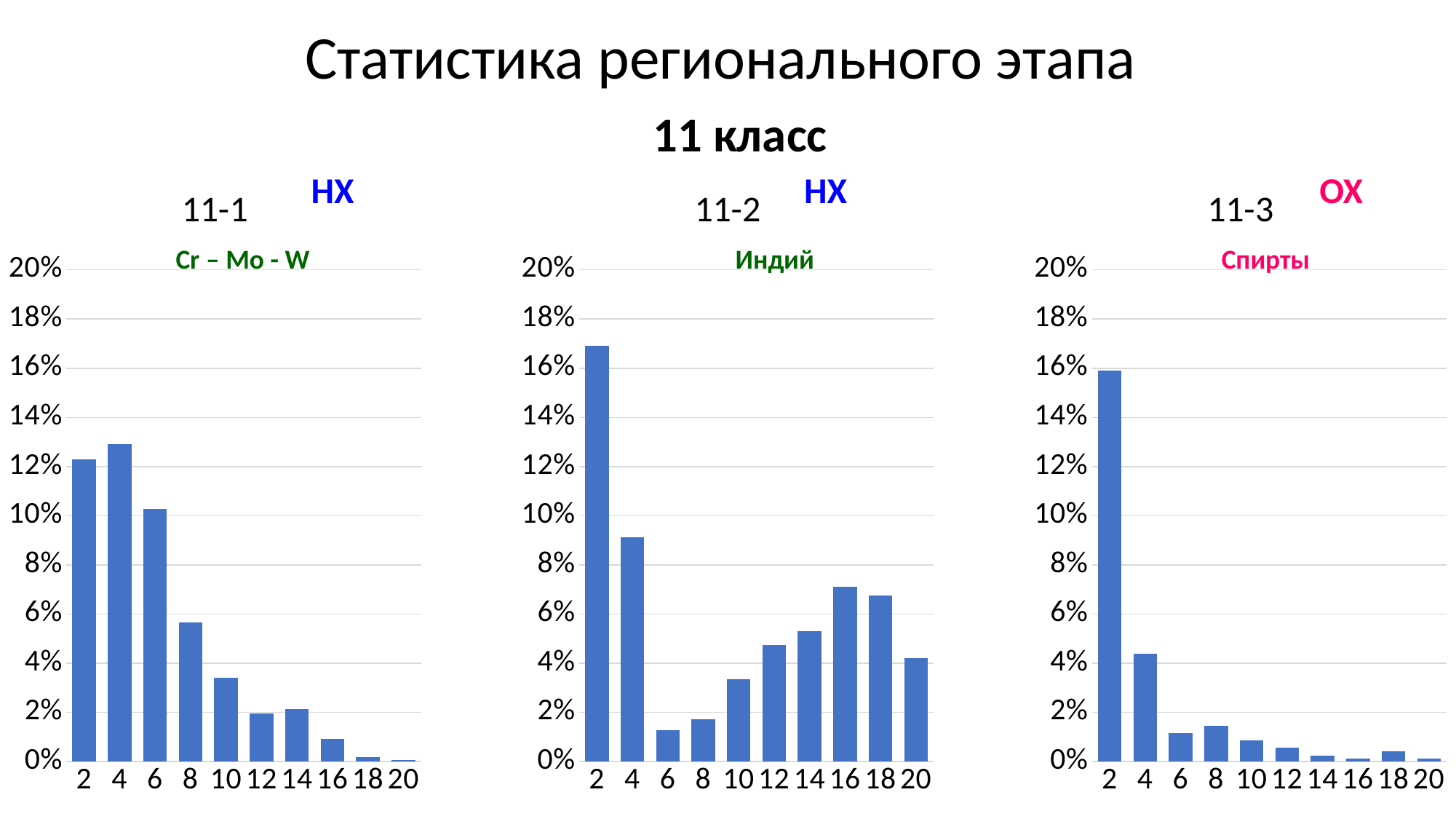
How many categories are shown on the x axis of the 11-1 chart (Cr – Mo - W)? 10 In the 11-2 chart (Индий), which is larger, the value for 4 or the value for 16? 4 In the 11-3 chart (Спирты), which category has the highest value? 2 How many charts are shown on the slide? 3 In the 11-2 chart (Индий), which category has the highest value? 2 In the 11-1 chart (Cr – Mo - W), is the value for 2 greater or less than 10%? greater What is the green subtitle shown above the 11-2 chart? Индий In the 11-3 chart (Спирты), is the value for 4 greater or less than 6%? less In the 11-1 chart (Cr – Mo - W), which is larger, the value for 6 or the value for 8? 6 In the 11-3 chart (Спирты), do the values generally rise or fall from 2 to 20 along the x axis? fall In the 11-2 chart (Индий), is the value for 2 greater or less than 16%? greater What kind of chart is the 11-1 chart (Cr – Mo - W)? bar chart